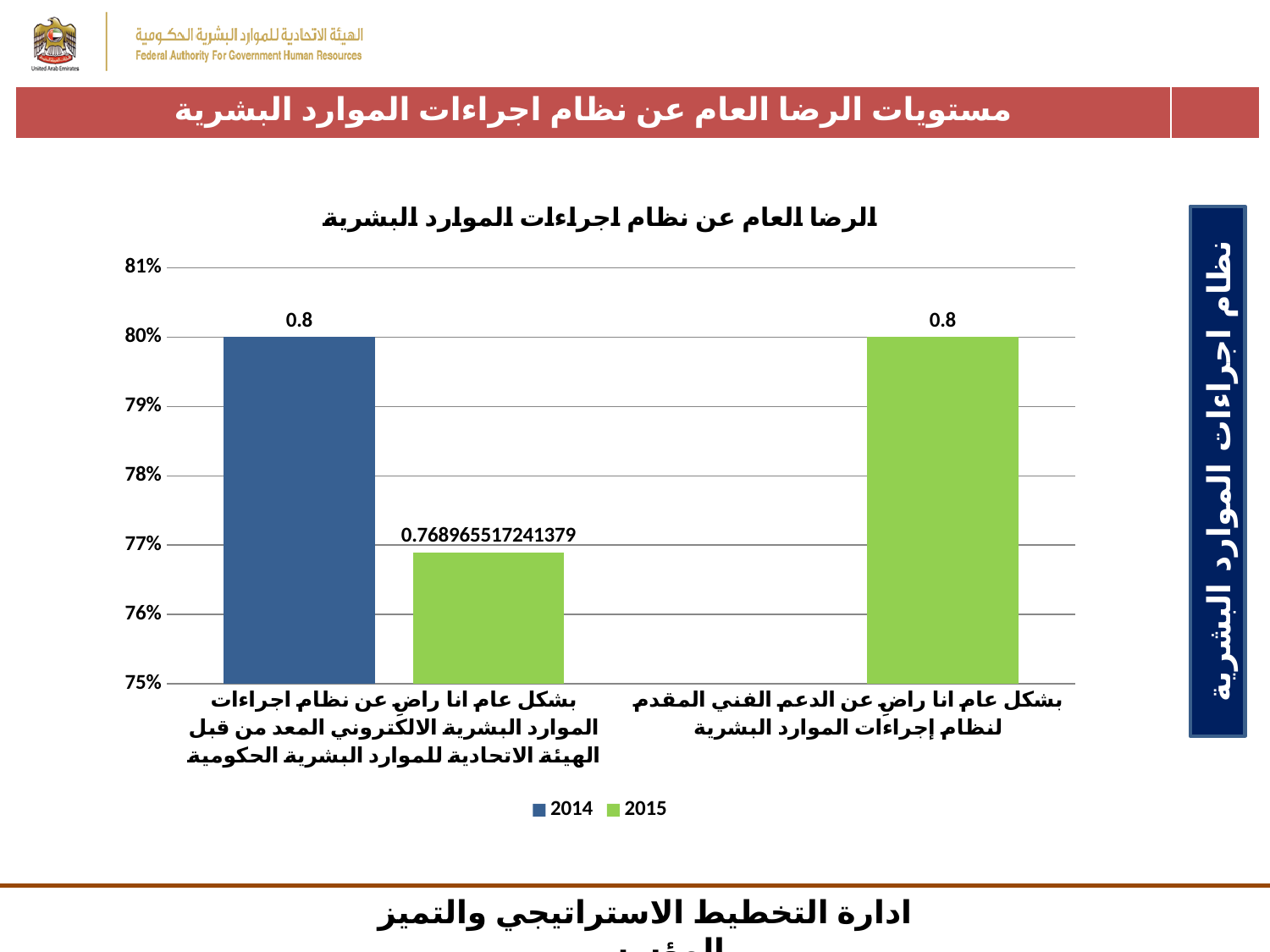
What kind of chart is shown on the slide? bar chart How many series does the legend list? 2 What are the series names in the legend? 2014 and 2015 What is the data label on the 2015 bar for the left category (satisfaction with the electronic HR procedures system)? 0.768965517241379 Which bar is the lowest in the chart? 2015 bar for the left category (electronic HR procedures system) Is the 2015 value for the left category (electronic HR procedures system) greater or less than 77%? less What is the title of the chart? الرضا العام عن نظام اجراءات الموارد البشرية What is the data label on the 2014 bar for the left category (satisfaction with the electronic HR procedures system)? 0.8 How many categories are shown on the x axis? 2 For the left category (electronic HR procedures system), which series has the larger value, 2014 or 2015? 2014 What is the data label on the 2015 bar for the right category (satisfaction with technical support for the HR procedures system)? 0.8 Is the 2014 value for the left category (electronic HR procedures system) greater or less than 79%? greater